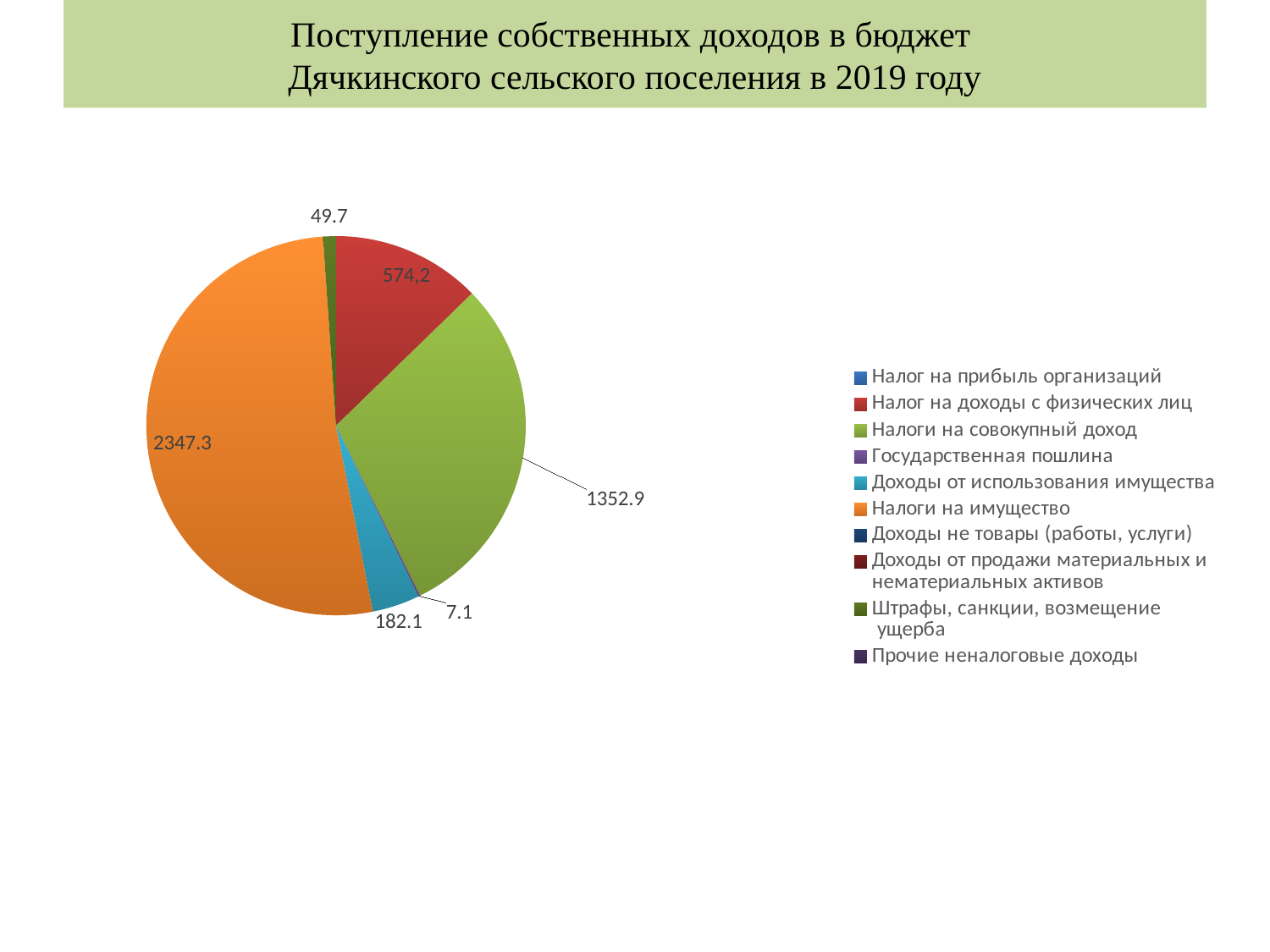
What is the difference between the values for Налоги на имущество and Налоги на совокупный доход? 994.4 Which category has the largest slice of the pie? Налоги на имущество How many categories are listed in the legend? 10 What type of chart is shown on the slide? pie chart What is the value of the slice for Доходы от использования имущества? 182.1 What is the value of the slice for Налоги на совокупный доход? 1352.9 Which is larger: the slice for Доходы от использования имущества or the slice for Штрафы, санкции, возмещение ущерба? Доходы от использования имущества What is the title of the slide? Поступление собственных доходов в бюджет Дячкинского сельского поселения в 2019 году What is the value of the slice for Штрафы, санкции, возмещение ущерба? 49.7 What is the value of the slice for Налоги на имущество? 2347.3 What is the value of the slice for Государственная пошлина? 7.1 What is the value of the slice for Налог на доходы с физических лиц? 574,2